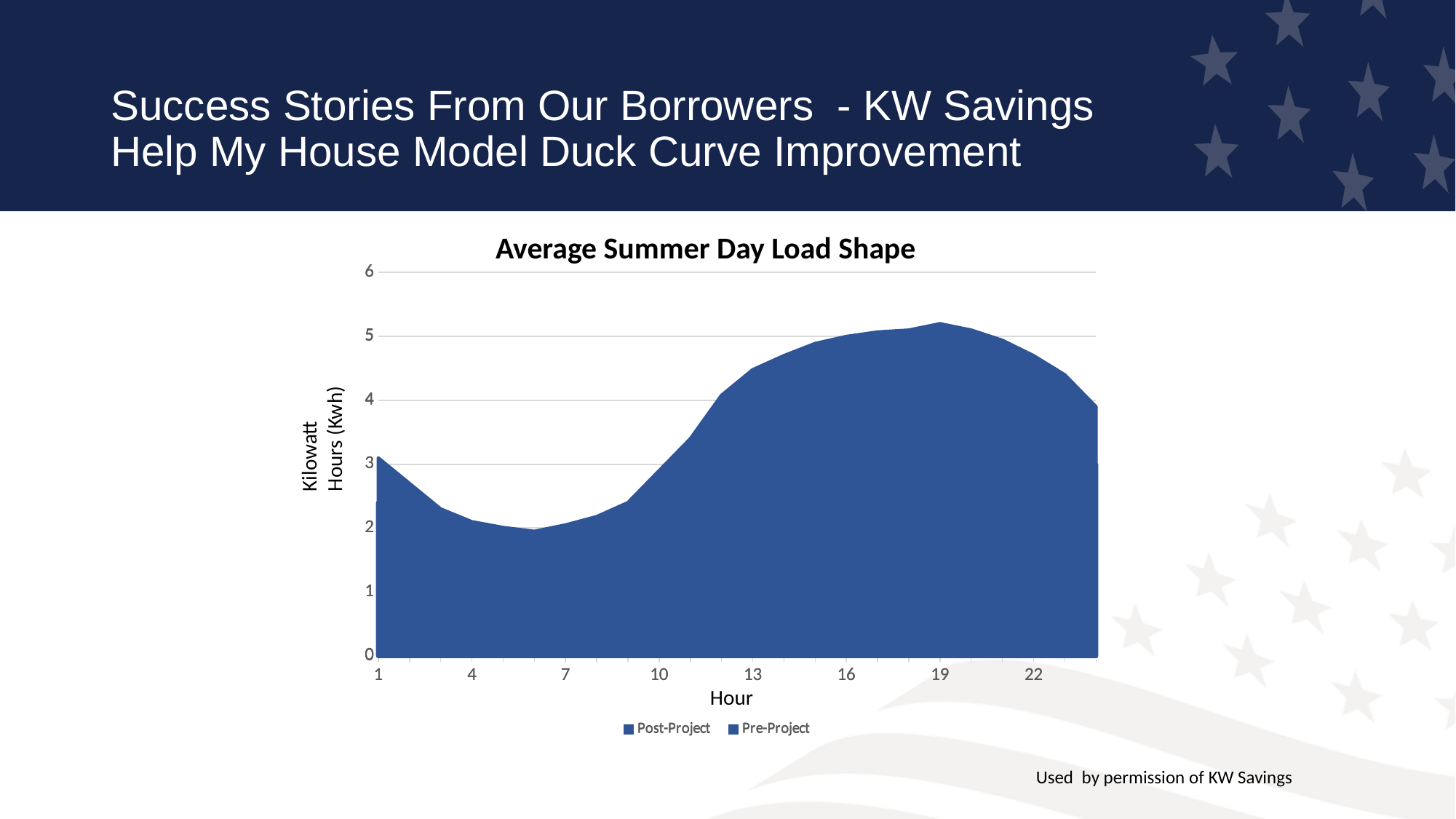
At which labeled hour does the load reach its highest value? 19 Is the value at hour 19 greater or less than 5? greater What is the title of the chart? Average Summer Day Load Shape What kind of chart is shown on the slide? Area chart Do the values rise or fall from hour 7 to hour 19? rise Is the value at hour 1 greater or less than 4? less What are the two series named in the legend? Post-Project and Pre-Project Is the value at hour 7 greater or less than 3? less How many series does the chart legend list? 2 Do the values rise or fall from hour 1 to hour 7? fall